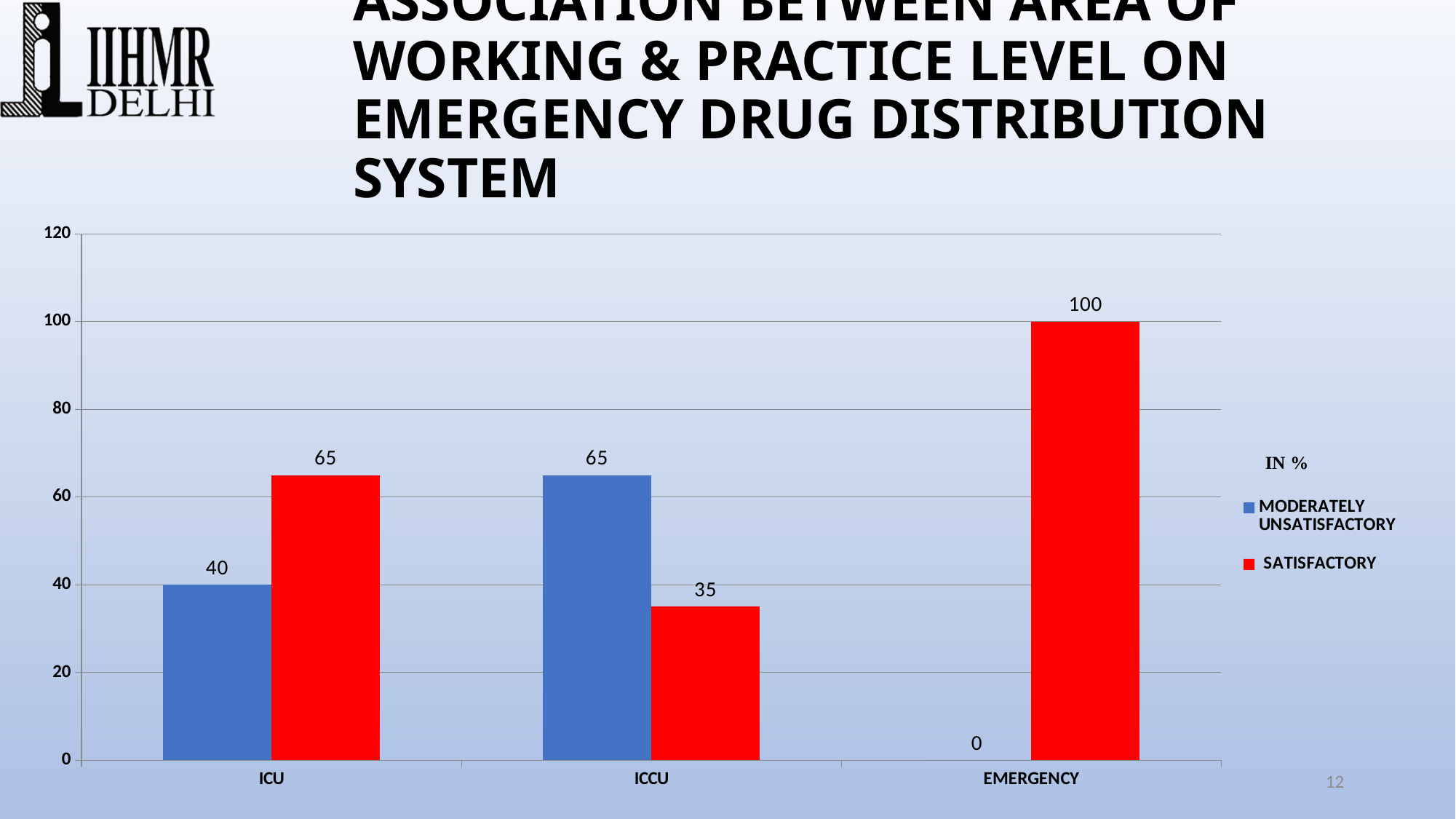
Which colour represents the SATISFACTORY series? Red What is the SATISFACTORY value for EMERGENCY? 100 For ICU, which is larger: the SATISFACTORY value or the MODERATELY UNSATISFACTORY value? SATISFACTORY What kind of chart is shown on the slide? Bar chart Which area has the highest SATISFACTORY value? EMERGENCY What is the SATISFACTORY value for ICU? 65 What is the MODERATELY UNSATISFACTORY value for ICCU? 65 How many areas of working are shown on the x axis? 3 How many series does the legend list? 2 What is the difference between the SATISFACTORY and MODERATELY UNSATISFACTORY values for ICCU? 30 Which area has the lowest MODERATELY UNSATISFACTORY value? EMERGENCY What is the MODERATELY UNSATISFACTORY value for EMERGENCY? 0